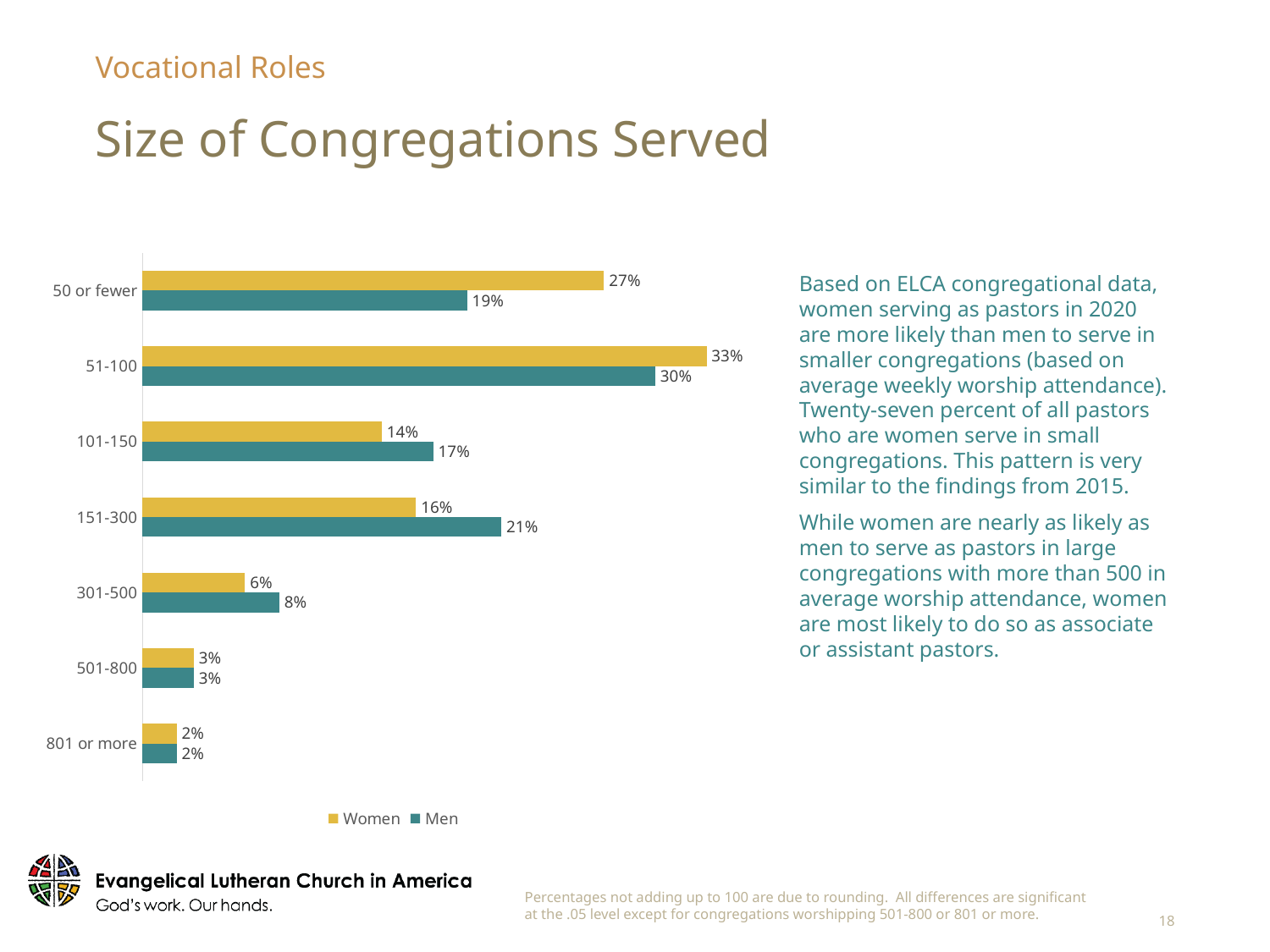
In the 101-150 category, which is larger, the value for Women or for Men? Men What kind of chart is shown on the slide? Bar chart How many series does the legend list? 2 How many congregation size categories are shown on the chart? 7 What is the value for Men in the 151-300 category? 21% What percentage of men serve congregations of 51-100? 30% Which series is shown in yellow? Women Which congregation size category has the lowest value for Men? 801 or more What is the difference between the Men and Women values for the 151-300 category? 5% Which congregation size category has the highest value for Women? 51-100 What percentage of women serve congregations of 50 or fewer? 27% What is the difference between the Women and Men values for the 50 or fewer category? 8%